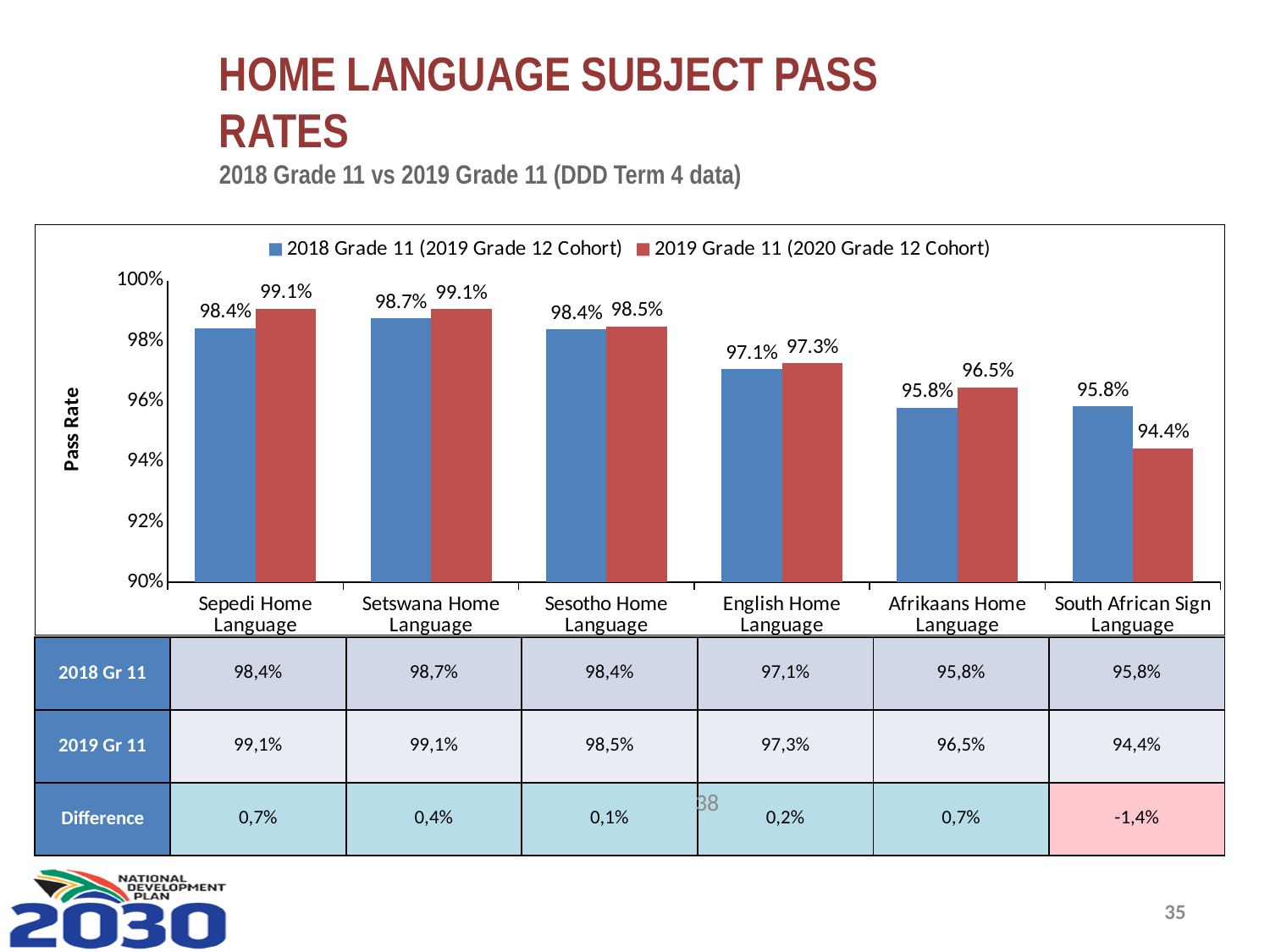
Do the 2019 Grade 11 pass rates rise or fall moving from left to right across the subjects? fall How many home language subjects are shown on the x axis? 6 Which home language subject has the lowest 2019 Grade 11 pass rate? South African Sign Language What is the 2019 Grade 11 pass rate for Afrikaans Home Language? 96.5% Which home language subject has the highest 2018 Grade 11 pass rate? Setswana Home Language For South African Sign Language, which is larger: the 2018 Grade 11 pass rate or the 2019 Grade 11 pass rate? 2018 Grade 11 How many series does the legend list? 2 Is the 2019 Grade 11 pass rate for English Home Language greater or less than 98%? less What kind of chart is shown on the slide? bar chart What is the difference between the 2019 and 2018 Grade 11 pass rates for Sepedi Home Language? 0.7% What is the 2019 Grade 11 pass rate for South African Sign Language? 94.4% What is the 2018 Grade 11 pass rate for Sepedi Home Language? 98.4%